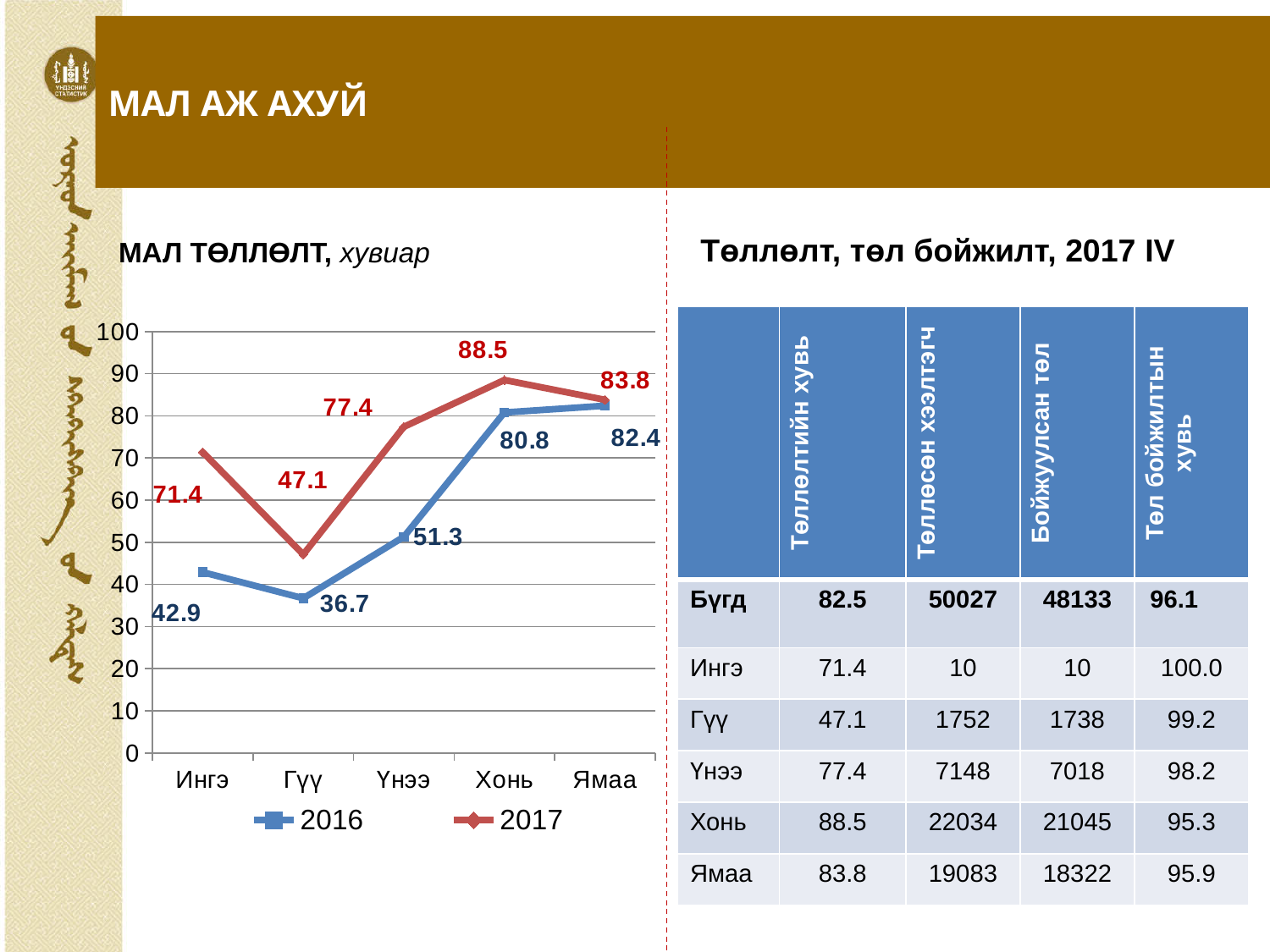
How many series does the chart legend list? 2 Which category has the highest 2017 value in the chart? Хонь Which is larger for Үнээ: the 2016 value or the 2017 value? 2017 What is the title of the chart? МАЛ ТӨЛЛӨЛТ, хувиар What type of chart is shown on the slide? line chart Is the 2016 value for Ямаа greater or less than 80? greater What is the 2017 value for Ингэ in the chart? 71.4 What is the 2016 value for Гүү in the chart? 36.7 What is the difference between the 2017 and 2016 values for Ингэ? 28.5 Which category has the lowest 2016 value in the chart? Гүү How many categories are shown on the x axis of the chart? 5 What is the 2017 value for Хонь in the chart? 88.5